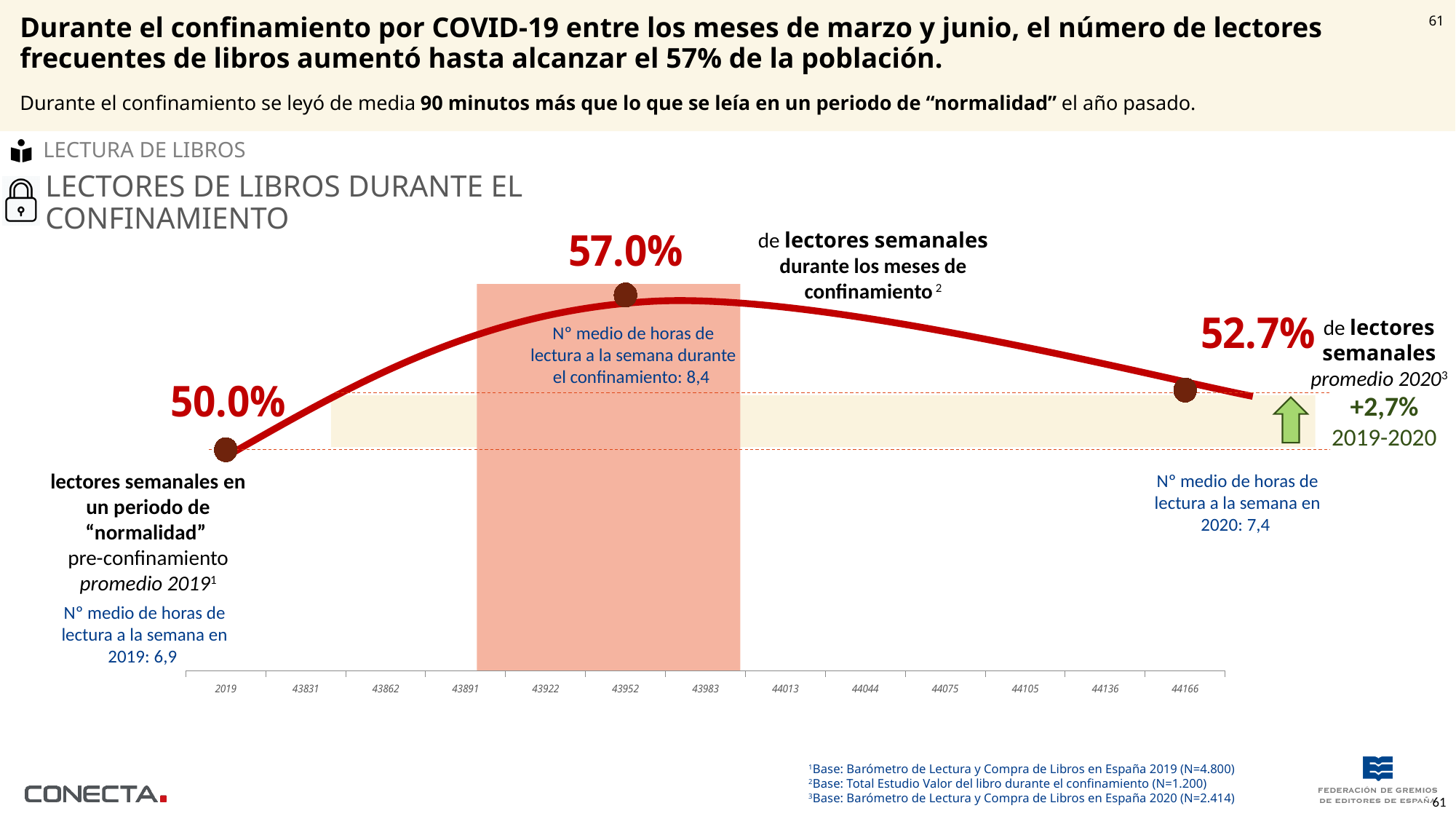
What percentage of weekly book readers is shown for the 2020 average (promedio 2020)? 52.7% What type of chart is used to show the share of weekly readers over time? Line chart How many labelled data points are marked on the line? 3 Is the value for the 2020 average larger or smaller than the value for the 2019 average? Larger What percentage of weekly book readers is shown during the months of confinement? 57.0% Which of the three labelled points on the line has the lowest value? Pre-confinement, promedio 2019 (50.0%) What average number of reading hours per week is annotated for the confinement period? 8,4 Which of the three labelled points on the line has the highest value? During confinement (57.0%) Does the line rise or fall from the confinement point to the 2020 average point? Falls What is the difference in percentage points between the confinement value and the 2019 pre-confinement value? 7.0 What percentage of weekly book readers is shown for the pre-confinement period (promedio 2019)? 50.0% What is the difference in percentage points between the 2020 average and the 2019 average? 2.7